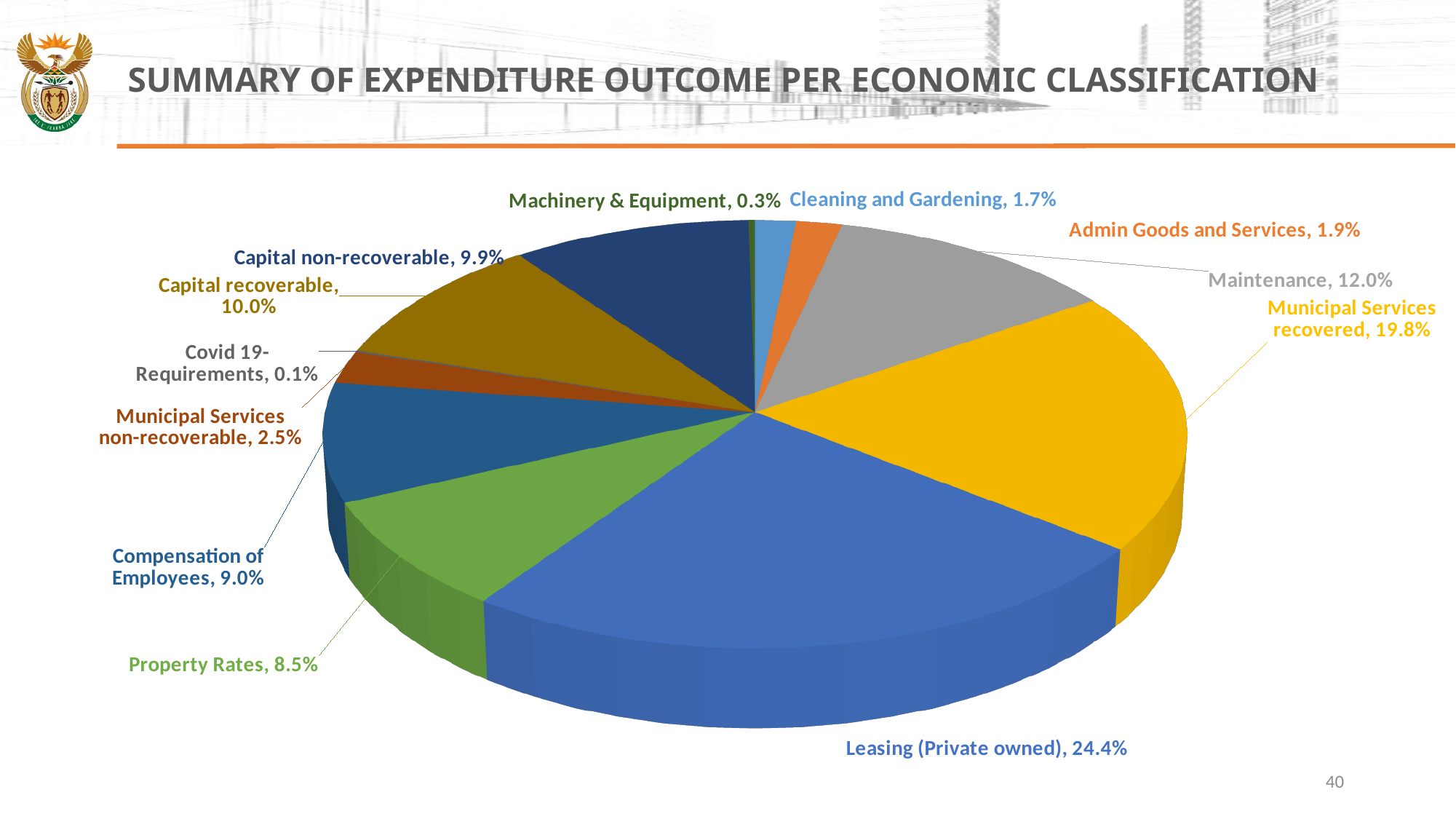
What is the difference in percentage points between Leasing (Private owned) and Municipal Services recovered? 4.6 Which category has the largest share of expenditure? Leasing (Private owned) What share of expenditure is Maintenance? 12.0% What is the difference in percentage points between Capital recoverable and Capital non-recoverable? 0.1 What share of expenditure is Municipal Services recovered? 19.8% Which category has the smallest share of expenditure? Covid 19-Requirements What is the title of the slide? SUMMARY OF EXPENDITURE OUTCOME PER ECONOMIC CLASSIFICATION How many categories are shown in the pie chart? 12 What share of expenditure is Covid 19-Requirements? 0.1% What share of expenditure is Leasing (Private owned)? 24.4% What kind of chart is shown on the slide? Pie chart Which is larger, Compensation of Employees or Property Rates? Compensation of Employees